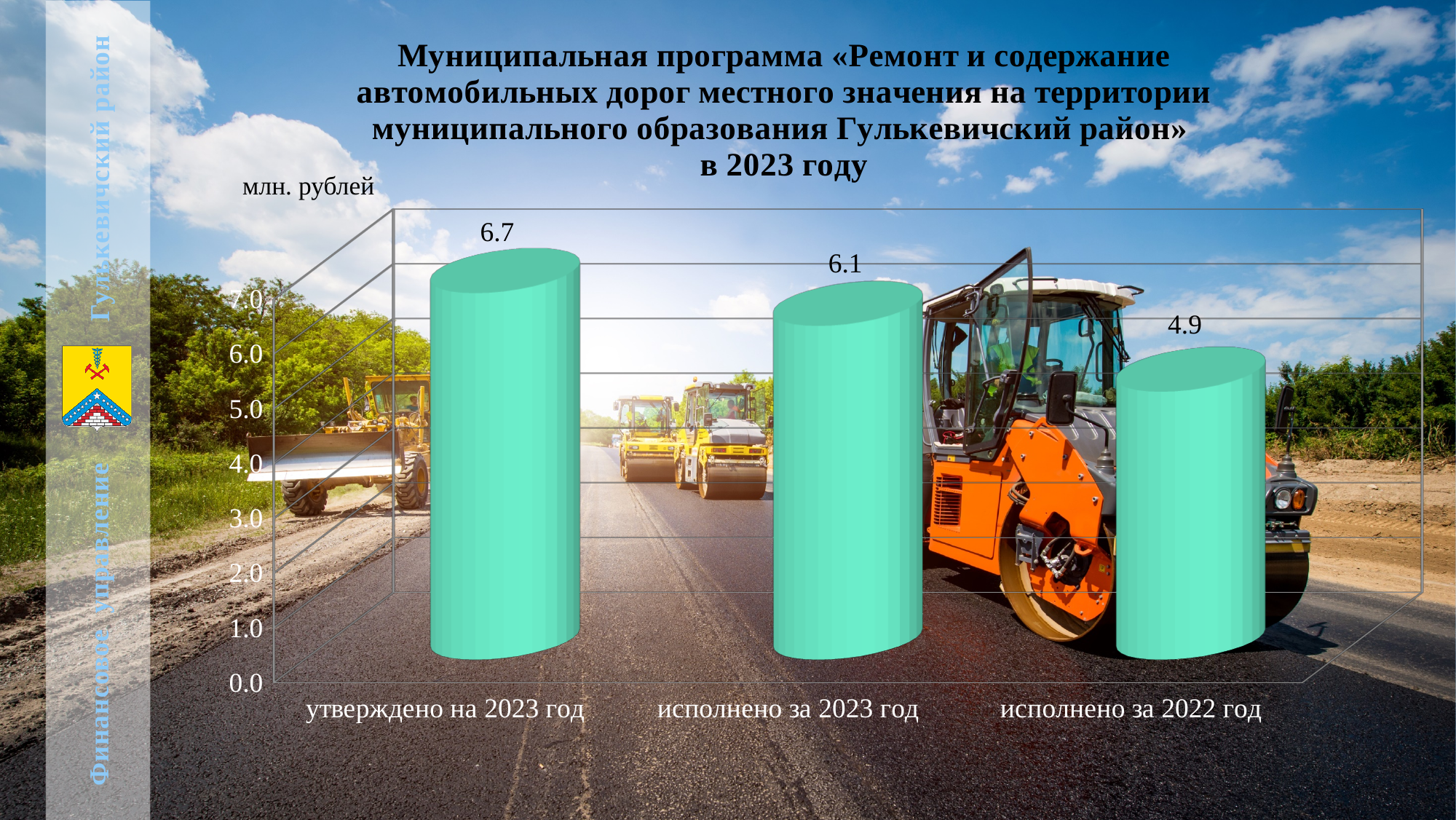
What unit is indicated on the vertical axis of the chart? млн. рублей How many categories are shown on the chart? 3 Which category has the lowest value? исполнено за 2022 год Which is larger: the value for «исполнено за 2023 год» or «исполнено за 2022 год»? исполнено за 2023 год What is the value for «исполнено за 2023 год»? 6.1 What kind of chart is shown on the slide? bar chart What is the difference between the value for «исполнено за 2023 год» and «исполнено за 2022 год»? 1.2 What is the value for «утверждено на 2023 год»? 6.7 Which category has the highest value? утверждено на 2023 год Is the value for «исполнено за 2022 год» greater or less than 5.0? less What is the difference between the value for «утверждено на 2023 год» and «исполнено за 2023 год»? 0.6 What is the value for «исполнено за 2022 год»? 4.9